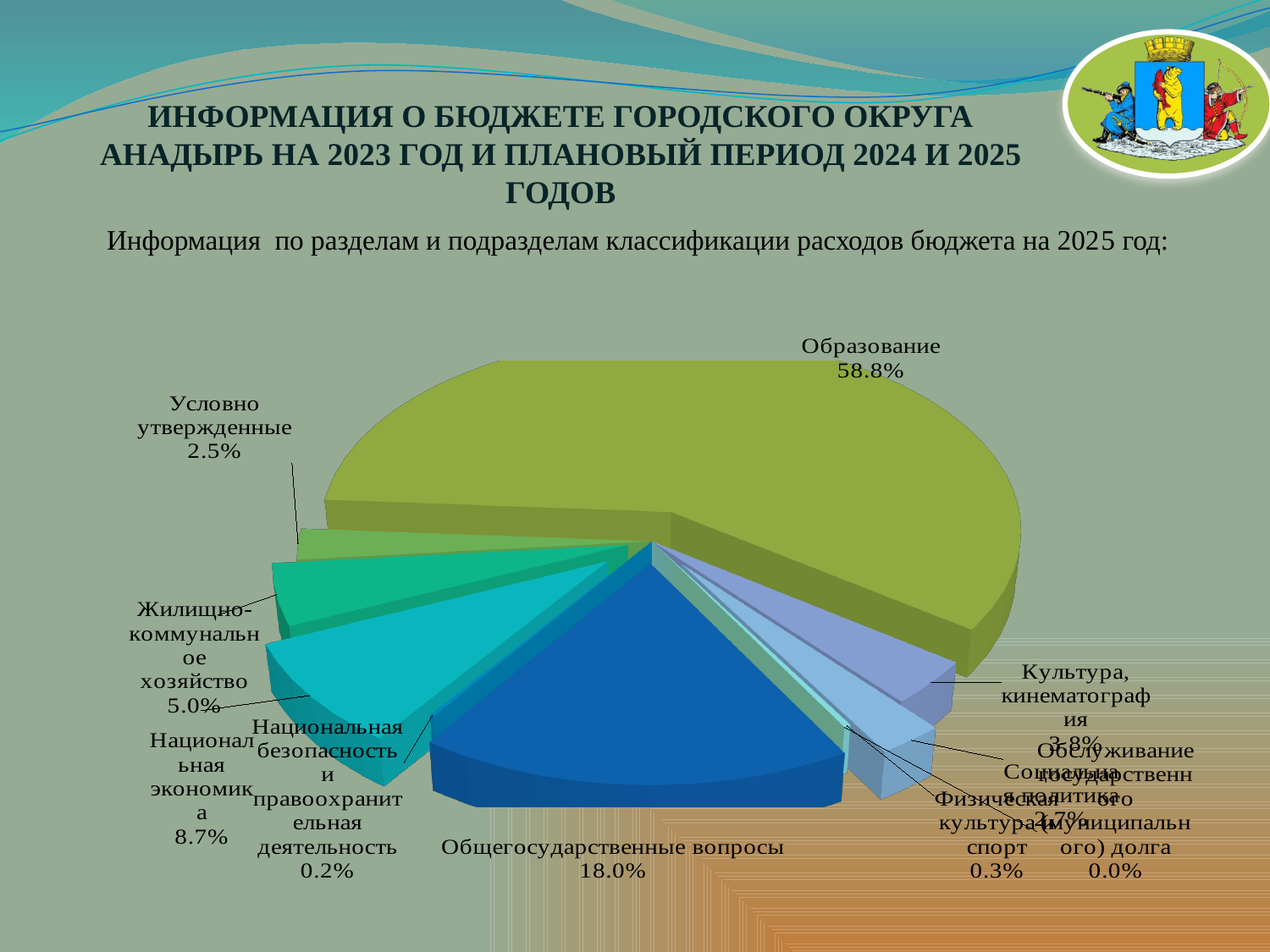
What share is shown for Жилищно-коммунальное хозяйство? 5.0% What share is shown for Физическая культура и спорт? 0.3% What share is shown for Условно утвержденные? 2.5% What share is shown for Общегосударственные вопросы? 18.0% Which category has the smallest share of the pie? Обслуживание государственного (муниципального) долга Which category has the largest share of the pie? Образование What type of chart is shown on the slide? pie chart What is the difference in percentage points between Образование and Общегосударственные вопросы? 40.8 What share is shown for Национальная экономика? 8.7% Which is larger, the share for Национальная экономика or the share for Жилищно-коммунальное хозяйство? Национальная экономика What share of the 2025 budget expenditure goes to Образование? 58.8% What share is shown for Национальная безопасность и правоохранительная деятельность? 0.2%